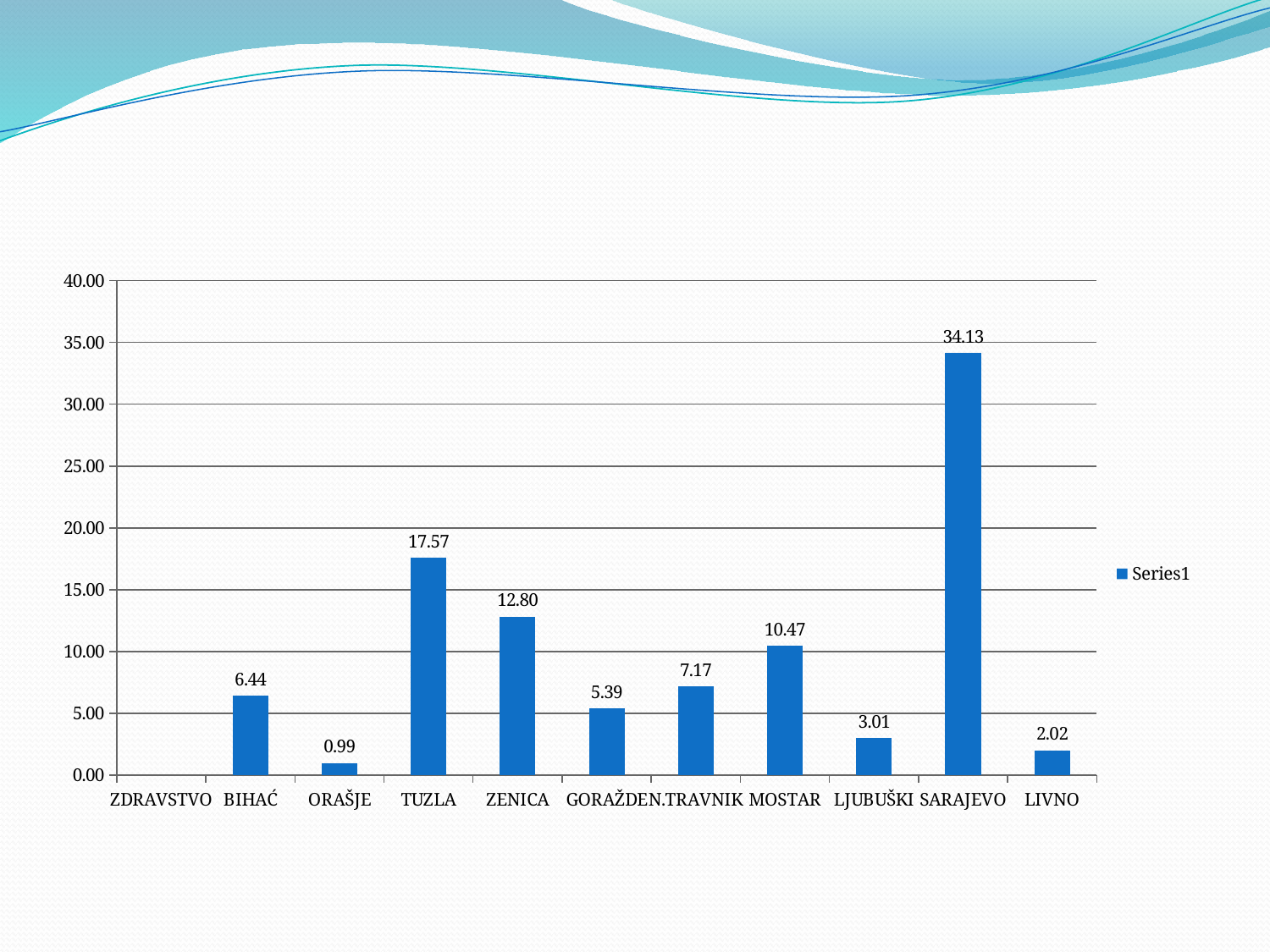
What kind of chart is shown on the slide? Bar chart How many series does the legend list? 1 What is the difference between the values for SARAJEVO and TUZLA? 16.56 Is the value for ZENICA greater or less than 10.00? greater Which is larger, the value for MOSTAR or the value for N.TRAVNIK? MOSTAR What is the difference between the values for TUZLA and ZENICA? 4.77 What is the value for SARAJEVO? 34.13 What is the value for LJUBUŠKI? 3.01 Which category has the highest value? SARAJEVO What is the value for ORAŠJE? 0.99 What is the value for TUZLA? 17.57 Among the bars with data labels, which category has the lowest value? ORAŠJE